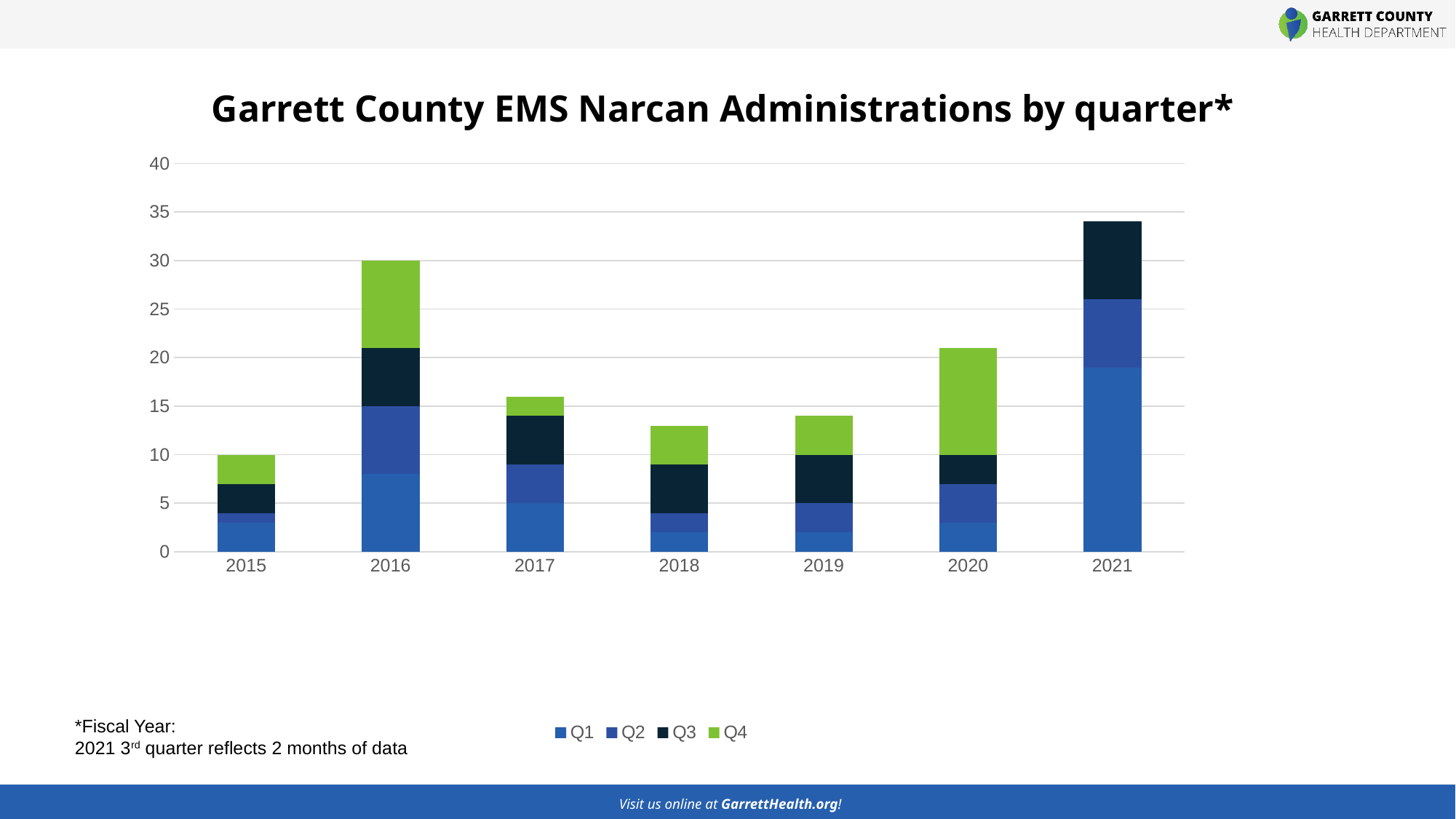
What is the title of the chart? Garrett County EMS Narcan Administrations by quarter* What kind of chart is shown on the slide? Stacked bar chart How many years are shown on the x axis of the chart? 7 What is the total height of the stacked bar for 2016? 30 How many series does the legend list? 4 What is the total height of the stacked bar for 2015? 10 Is the total for 2021 greater or less than 30? greater Which year has the tallest stacked bar? 2021 Which year has the shortest stacked bar? 2015 Is the total for 2018 greater or less than 15? less Do the bar totals rise or fall from 2018 to 2021? Rise Which year has a larger total, 2016 or 2020? 2016